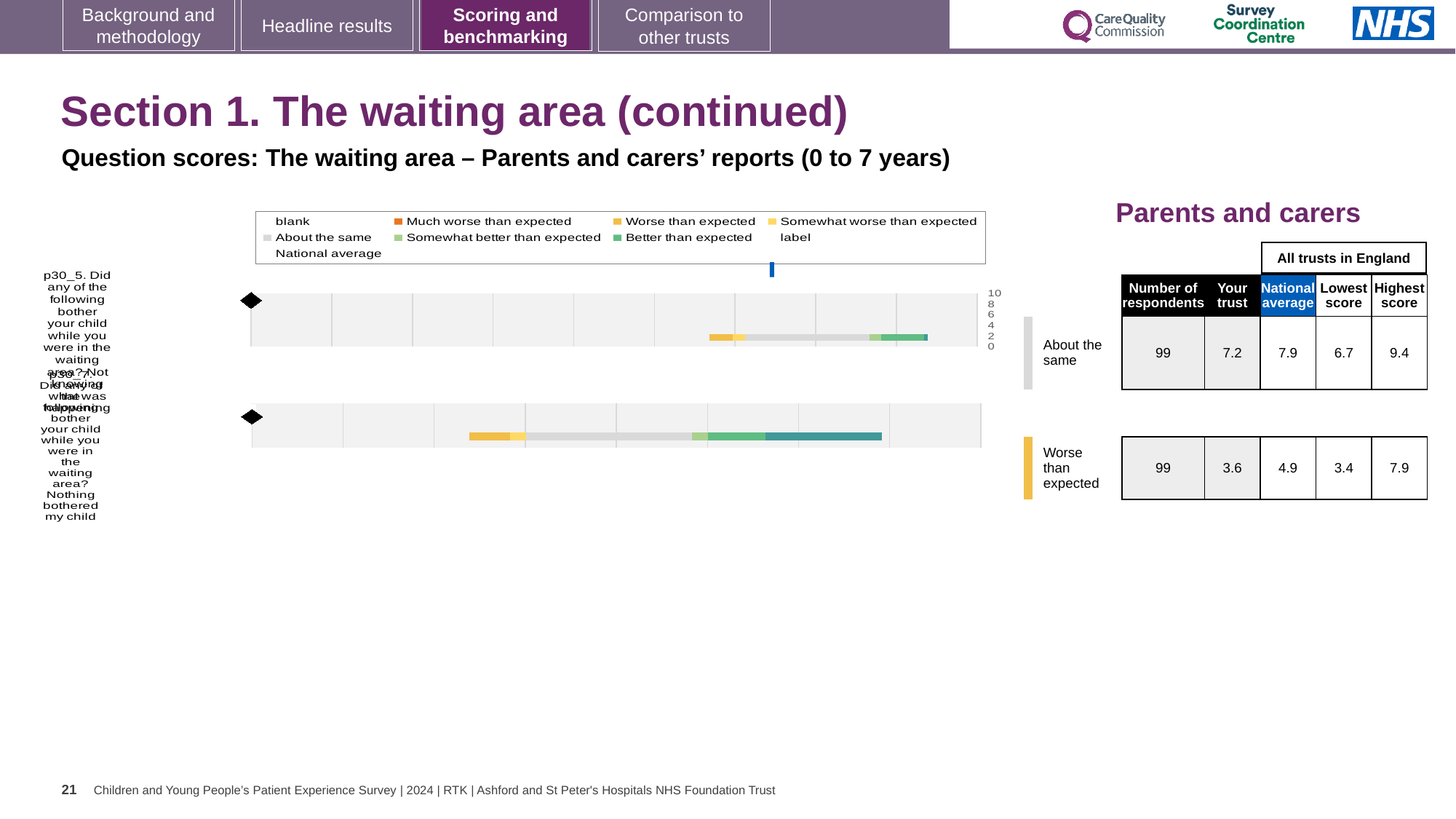
Is the trust score for the question rated 'About the same' greater or less than 6 on the chart axis? greater What colour does the legend use for 'Much worse than expected'? orange What is the 'Your trust' score for the question rated 'Worse than expected'? 3.6 What is the 'Your trust' score for the question rated 'About the same'? 7.2 How many question bars are plotted in the chart? 2 How many entries does the chart legend list? 9 What is the national average for the question rated 'Worse than expected'? 4.9 What kind of chart is shown on the slide? bar chart What is the difference between the highest and lowest scores for the question rated 'Worse than expected'? 4.5 Which question has the higher trust score: the one rated 'About the same' or the one rated 'Worse than expected'? About the same How many respondents answered the question rated 'About the same'? 99 What is the difference between the national average and the trust score for the question rated 'About the same'? 0.7